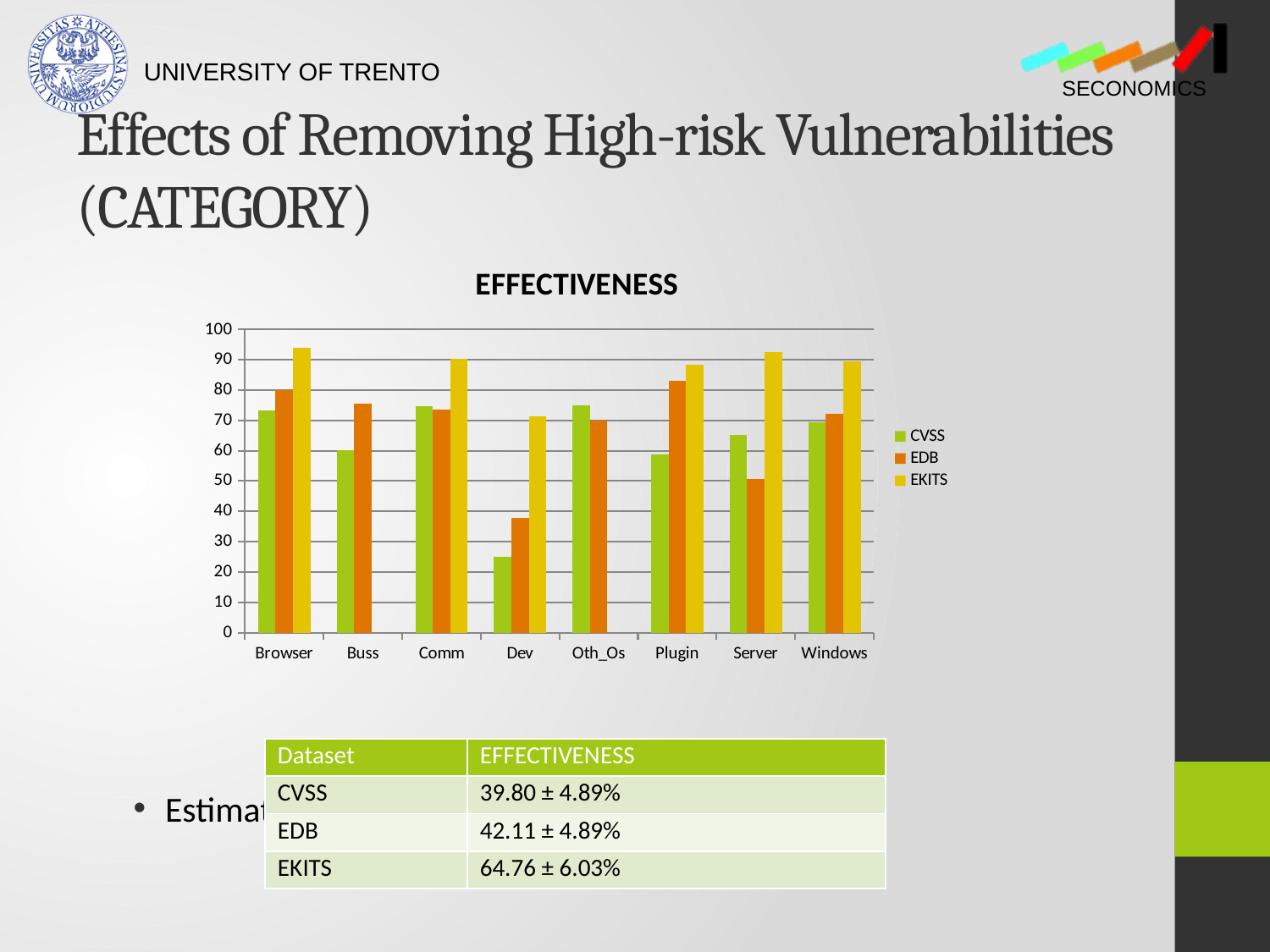
Is the EKITS value for Browser greater or less than 90? greater Which category has the lowest CVSS value in the EFFECTIVENESS chart? Dev For Plugin, which is larger: the CVSS value or the EDB value? EDB Is the EDB value for Dev greater or less than 40? less For Server, which is larger: the CVSS value or the EDB value? CVSS What is the title of the chart on the slide? EFFECTIVENESS How many categories are shown on the x axis of the EFFECTIVENESS chart? 8 How many series does the legend of the EFFECTIVENESS chart list? 3 What kind of chart is shown on the slide? bar chart Is the CVSS value for Buss greater or less than 70? less